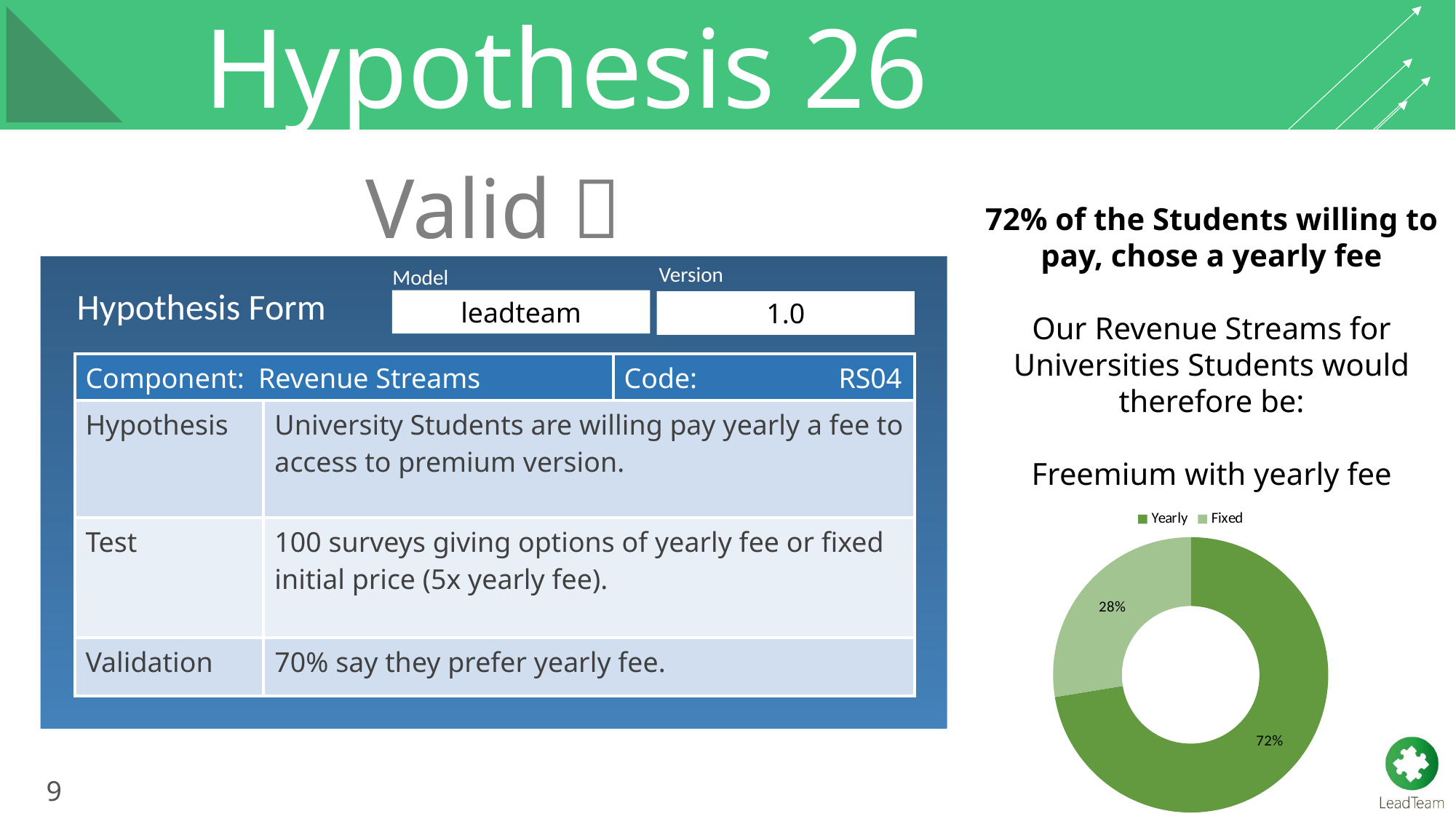
How many entries does the chart legend list? 2 What kind of chart is shown on the slide? Doughnut chart Which category has the smallest share in the doughnut chart? Fixed What percentage of the doughnut chart is labelled Fixed? 28% Which is larger in the chart, the Yearly share or the Fixed share? Yearly What are the two legend entries of the chart? Yearly and Fixed What is the difference in percentage points between the Yearly and Fixed shares in the chart? 44 Which legend entry is shown in the darker green colour? Yearly What percentage of the doughnut chart is labelled Yearly? 72% How many categories does the doughnut chart show? 2 What share of the chart does the Yearly slice represent? 72% Which category has the largest share in the doughnut chart? Yearly